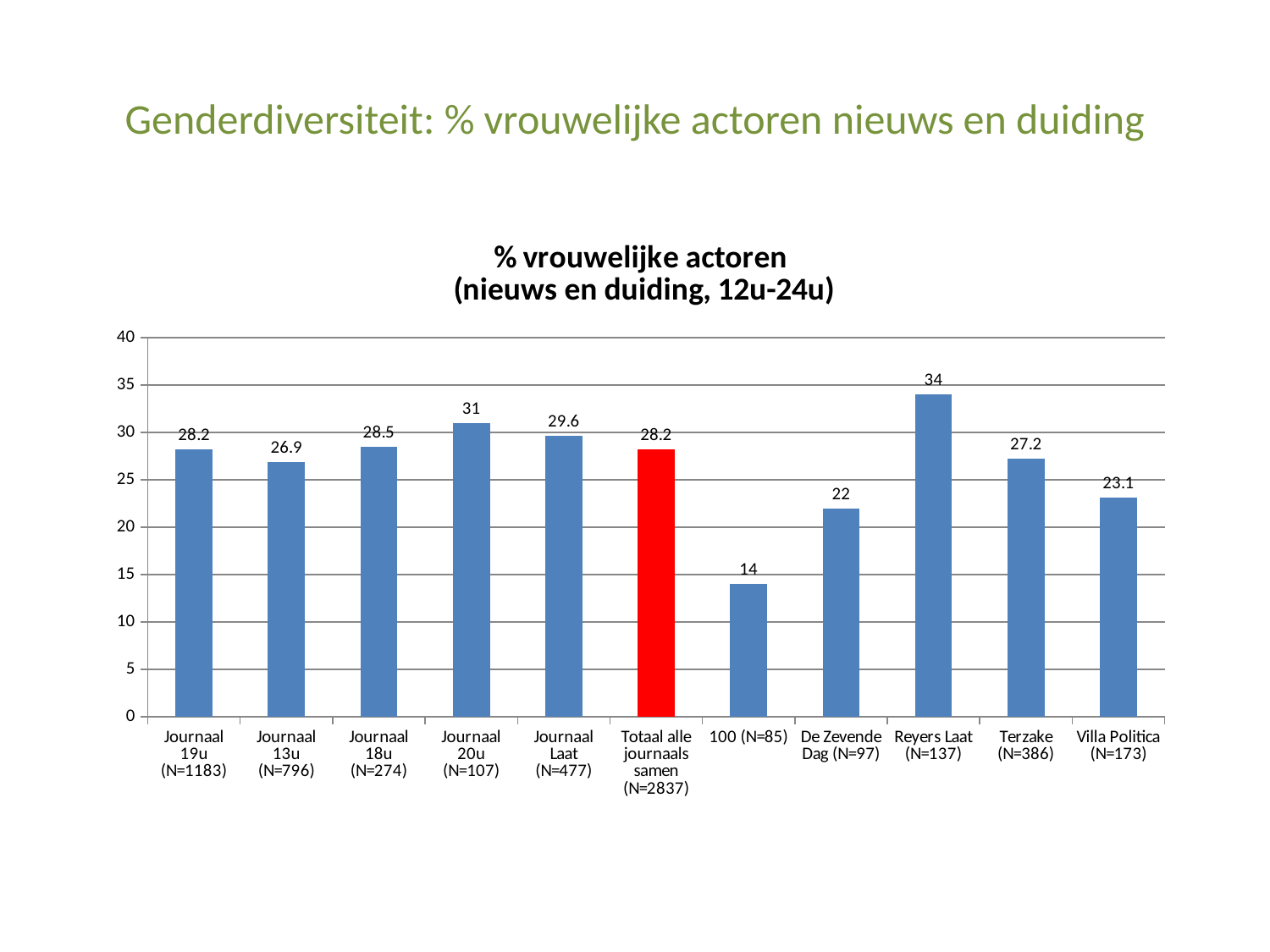
How many categories are shown on the x axis? 11 Which category has the lowest value? 100 (N=85) What is the value for Journaal 19u (N=1183)? 28.2 What is the value for Reyers Laat (N=137)? 34 What is the value for Totaal alle journaals samen (N=2837)? 28.2 What is the difference between the values for Reyers Laat (N=137) and Villa Politica (N=173)? 10.9 Which is larger, the value for Journaal 20u (N=107) or the value for Journaal Laat (N=477)? Journaal 20u (N=107) What is the value for 100 (N=85)? 14 Which category has the highest value? Reyers Laat (N=137) Which bar is coloured red instead of blue? Totaal alle journaals samen (N=2837) What kind of chart is shown? bar chart Is the value for De Zevende Dag (N=97) greater or less than 25? less